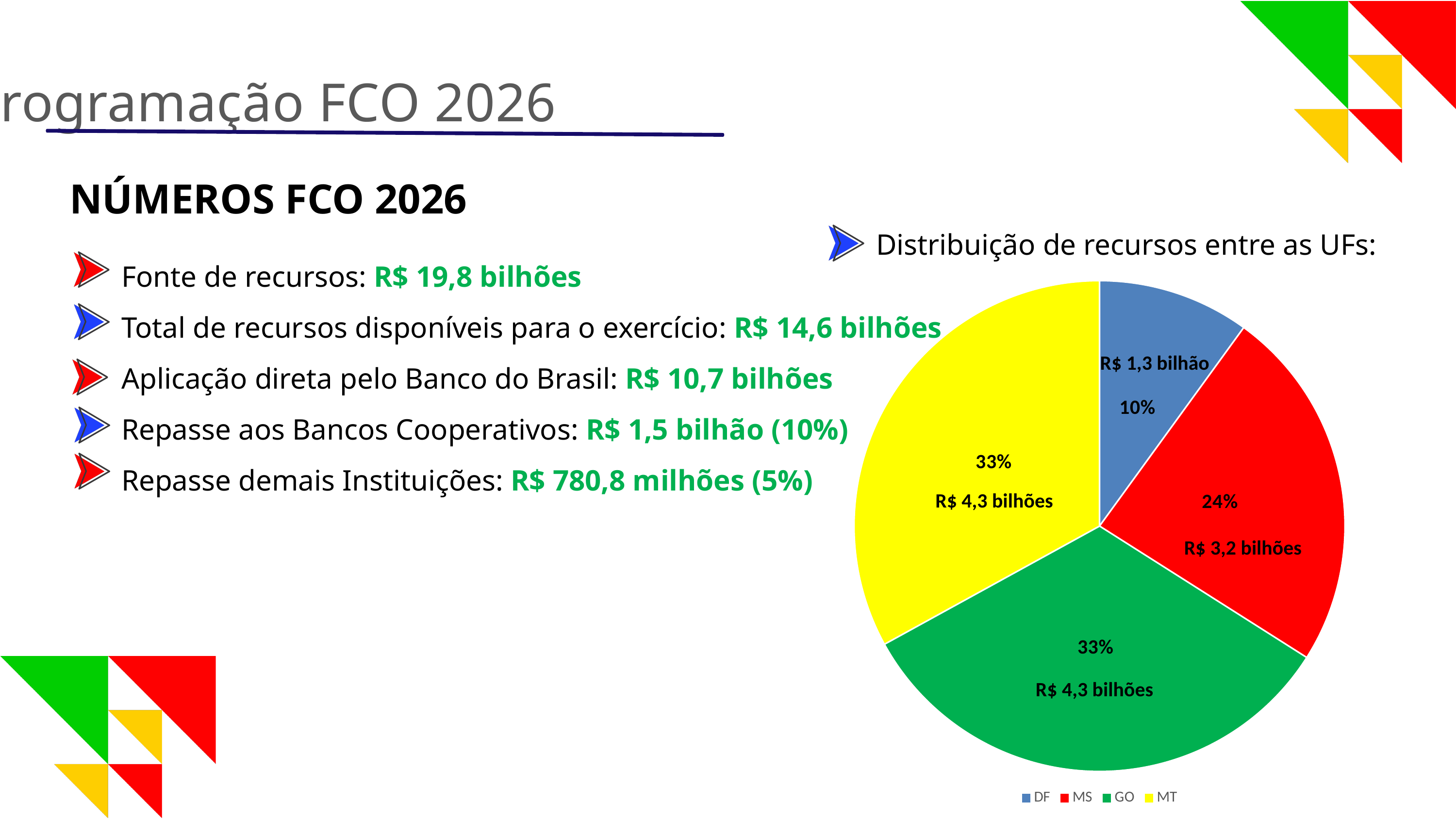
Which slice is larger in the pie chart, MS or DF? MS What is the difference in percentage points between the MS slice and the DF slice? 14% How many slices does the pie chart have? 4 What percentage share does DF have in the pie chart? 10% What percentage share does MT have in the pie chart? 33% Which UF has the smallest slice in the pie chart? DF What colour is the MT slice in the pie chart? yellow What is the value shown for DF in the pie chart? R$ 1,3 bilhão How many entries does the legend of the pie chart list? 4 What is the value shown for GO in the pie chart? R$ 4,3 bilhões What kind of chart is shown on the slide? pie chart What is the value shown for MS in the pie chart? R$ 3,2 bilhões